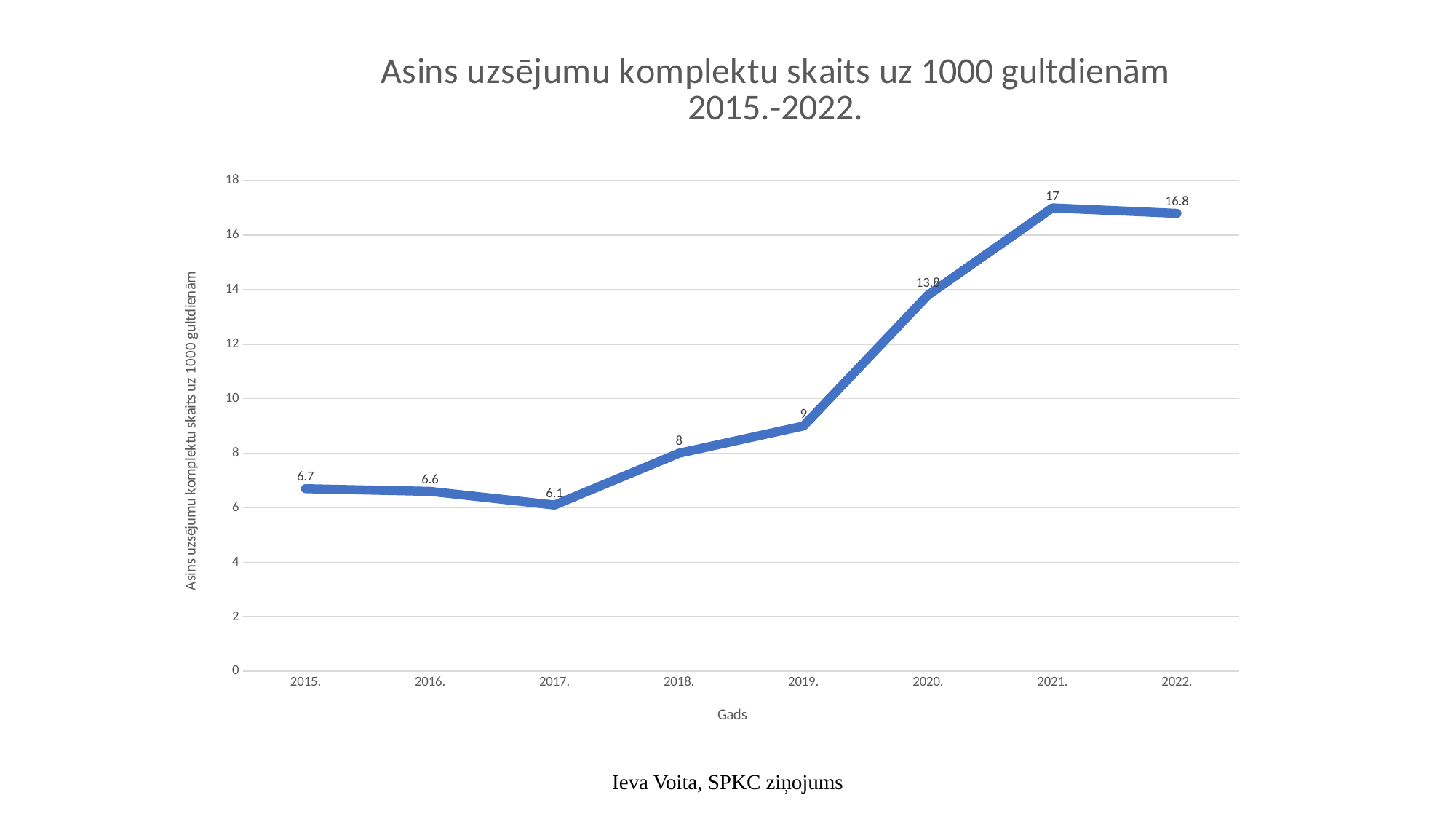
How many years are plotted on the x axis? 8 Which year has the highest value? 2021. Is the value for 2020. greater or less than 12? greater What is the value for 2020.? 13.8 Which year has the lowest value? 2017. What is the difference between the values for 2021. and 2015.? 10.3 What kind of chart is shown on the slide? line chart What is the value for 2015.? 6.7 What is the label of the x axis? Gads What is the value for 2022.? 16.8 Which is larger, the value for 2019. or the value for 2018.? 2019. Do the values rise or fall from 2017. to 2021.? rise